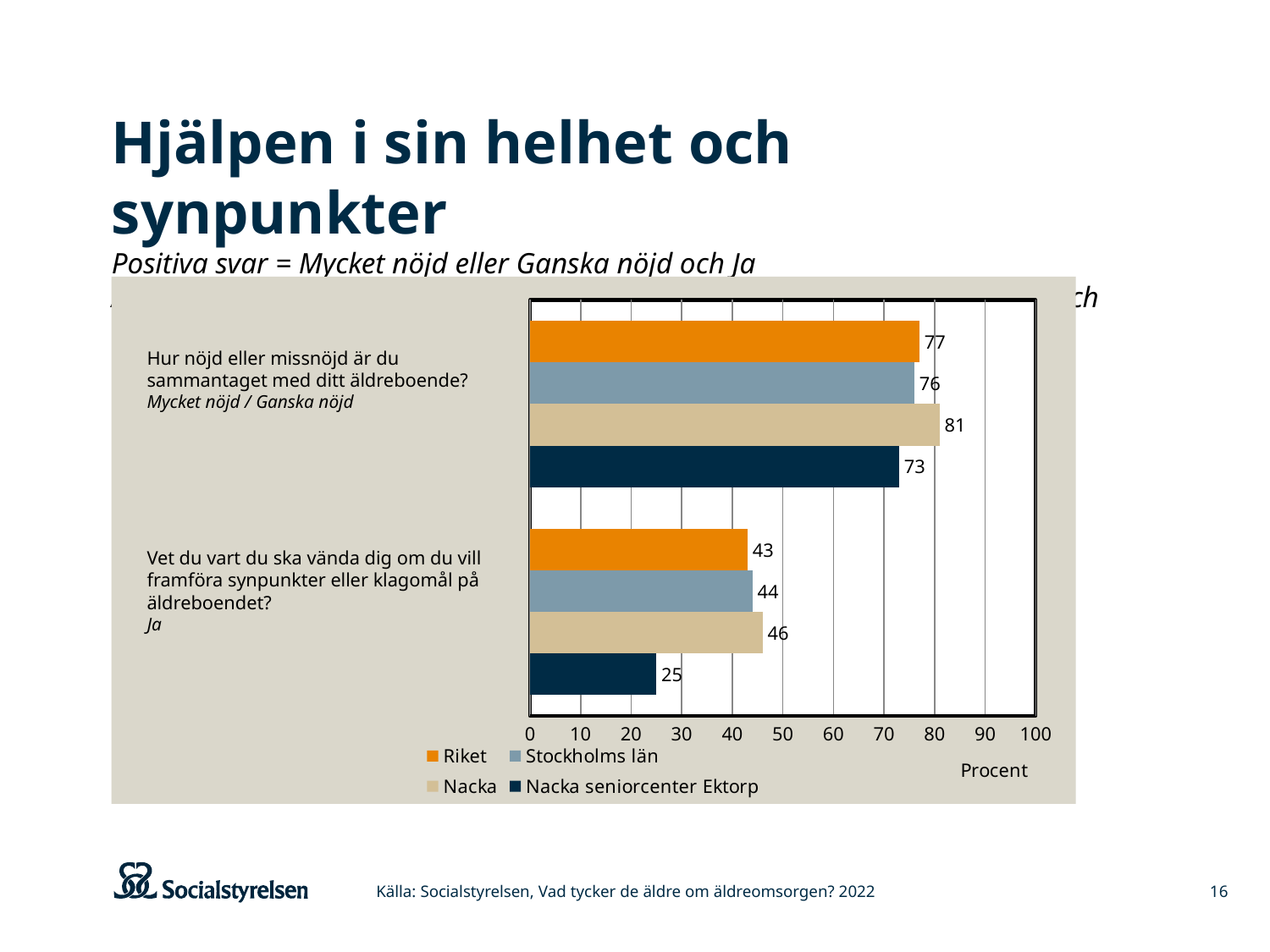
What is the value for Riket on the question "Vet du vart du ska vända dig om du vill framföra synpunkter eller klagomål på äldreboendet?"? 43 How many series does the legend list? 4 What is the value for Nacka seniorcenter Ektorp on the question "Vet du vart du ska vända dig om du vill framföra synpunkter eller klagomål på äldreboendet?"? 25 What is the value for Nacka on the question "Hur nöjd eller missnöjd är du sammantaget med ditt äldreboende?"? 81 Which series has the lowest value on the question "Vet du vart du ska vända dig om du vill framföra synpunkter eller klagomål på äldreboendet?"? Nacka seniorcenter Ektorp What is the difference between the Nacka value and the Nacka seniorcenter Ektorp value on the question "Hur nöjd eller missnöjd är du sammantaget med ditt äldreboende?"? 8 What is the label on the horizontal axis of the chart? Procent What is the difference between the Stockholms län value and the Nacka seniorcenter Ektorp value on the question "Vet du vart du ska vända dig om du vill framföra synpunkter eller klagomål på äldreboendet?"? 19 How many question categories are shown on the chart? 2 Which is larger on the question "Hur nöjd eller missnöjd är du sammantaget med ditt äldreboende?": the value for Riket or the value for Nacka seniorcenter Ektorp? Riket What kind of chart is shown on the slide? bar chart Which series has the highest value on the question "Hur nöjd eller missnöjd är du sammantaget med ditt äldreboende?"? Nacka